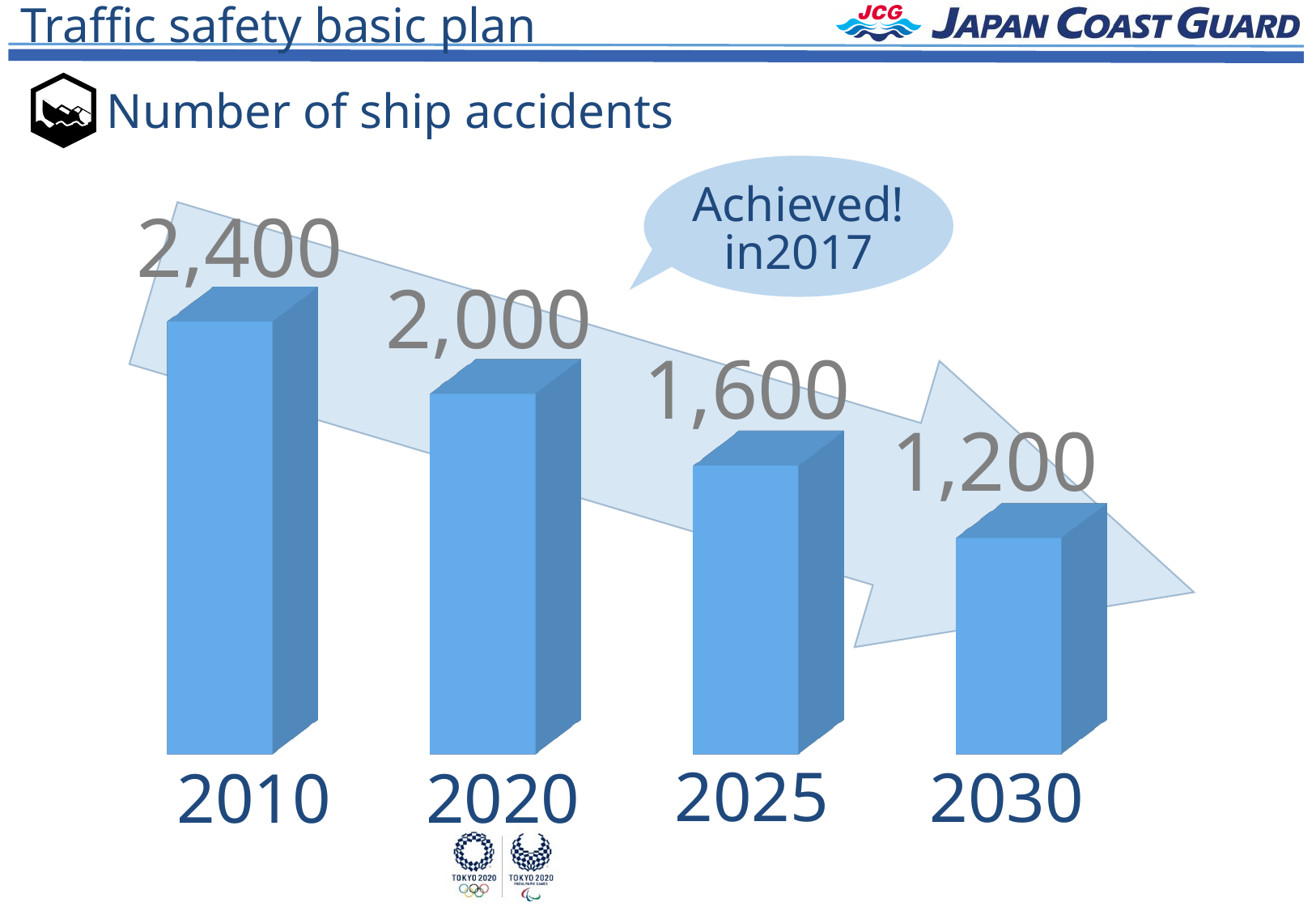
What is the difference between the values for 2010 and 2030? 1,200 Which is larger, the value for 2020 or the value for 2025? 2020 What is the number of ship accidents shown for 2020? 2,000 Which year has the highest number of ship accidents? 2010 What is the difference between the values for 2020 and 2025? 400 What is the number of ship accidents shown for 2010? 2,400 What is the number of ship accidents shown for 2025? 1,600 Which year has the lowest number of ship accidents? 2030 What is the number of ship accidents shown for 2030? 1,200 Do the values rise or fall from 2010 to 2030? fall How many years are shown on the chart? 4 What kind of chart is this? bar chart